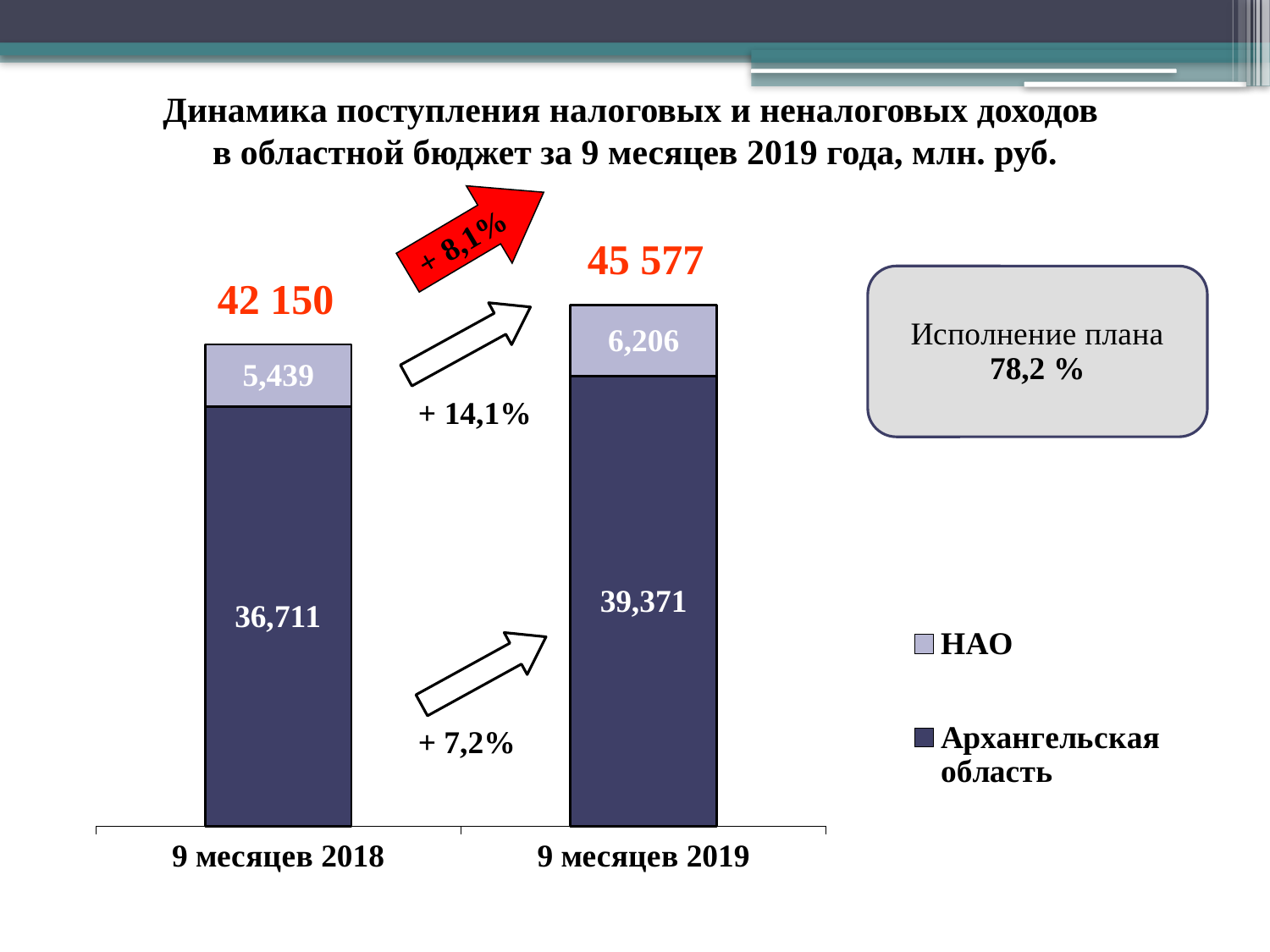
How many categories are shown on the x axis? 2 What is the total of the stacked bar for 9 месяцев 2018? 42 150 What is the value for Архангельская область in 9 месяцев 2018? 36,711 What is the difference between the Архангельская область values for 9 месяцев 2019 and 9 месяцев 2018? 2,660 What is the difference between the НАО values for 9 месяцев 2019 and 9 месяцев 2018? 767 What kind of chart is shown on the slide? Stacked bar chart What is the total of the stacked bar for 9 месяцев 2019? 45 577 What is the value for Архангельская область in 9 месяцев 2019? 39,371 What is the value for НАО in 9 месяцев 2019? 6,206 What is the value for НАО in 9 месяцев 2018? 5,439 How many series does the legend list? 2 Which period has the higher value for Архангельская область, 9 месяцев 2018 or 9 месяцев 2019? 9 месяцев 2019